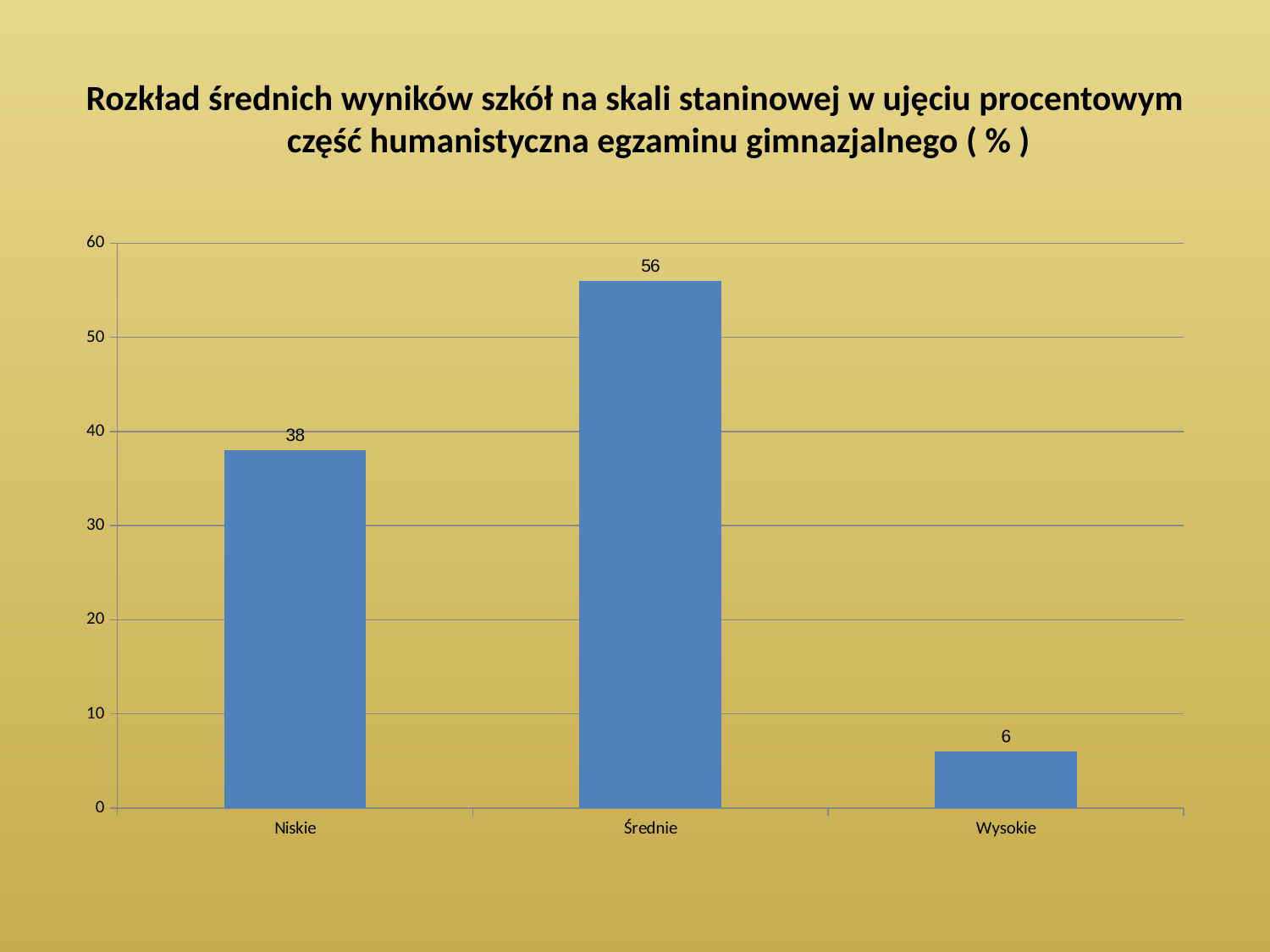
What is the highest value shown on the vertical axis? 60 What is the value for Wysokie? 6 Which is larger, the value for Niskie or the value for Wysokie? Niskie Is the value for Średnie greater or less than 50? greater Which category has the lowest value? Wysokie Which category has the highest value? Średnie How many categories are shown on the x axis? 3 What is the value for Niskie? 38 What is the difference between the values for Średnie and Niskie? 18 What is the value for Średnie? 56 What kind of chart is shown on the slide? bar chart What is the difference between the values for Niskie and Wysokie? 32